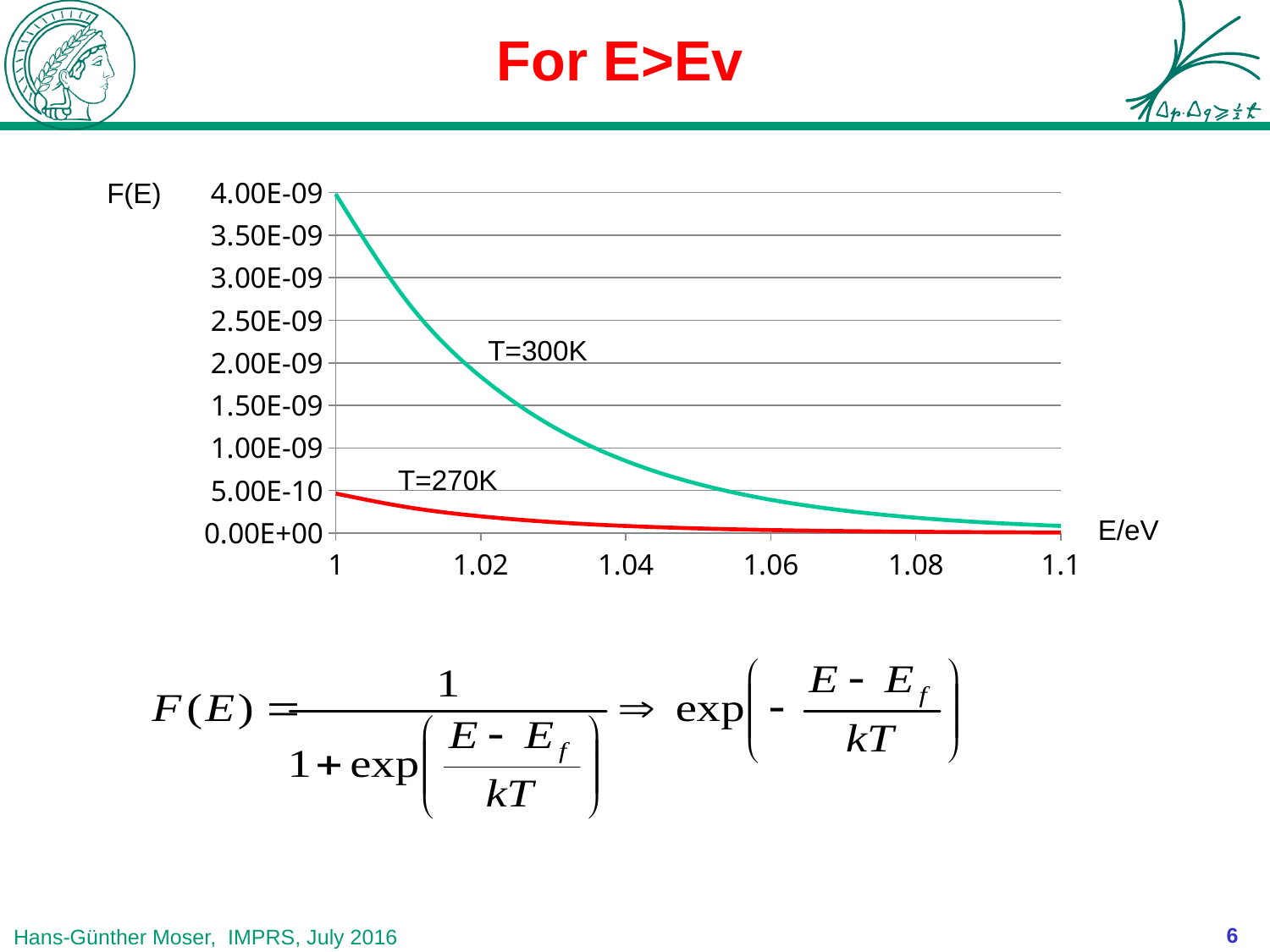
What is the label on the x axis of the chart? E/eV How many curves are plotted on the chart? 2 Is the value of the T=270K curve at E=1 greater or less than 1.00E-09? less Is the value of the T=300K curve at E=1 greater or less than 3.50E-09? greater Is the value of the T=300K curve at E=1.04 greater or less than 1.50E-09? less Do the values of the T=300K curve rise or fall as E increases along the x axis? fall Which curve reaches the highest value on the chart? T=300K What colour is the T=270K curve? red What kind of chart is shown on the slide? line chart Which curve has the higher value at E=1, T=300K or T=270K? T=300K